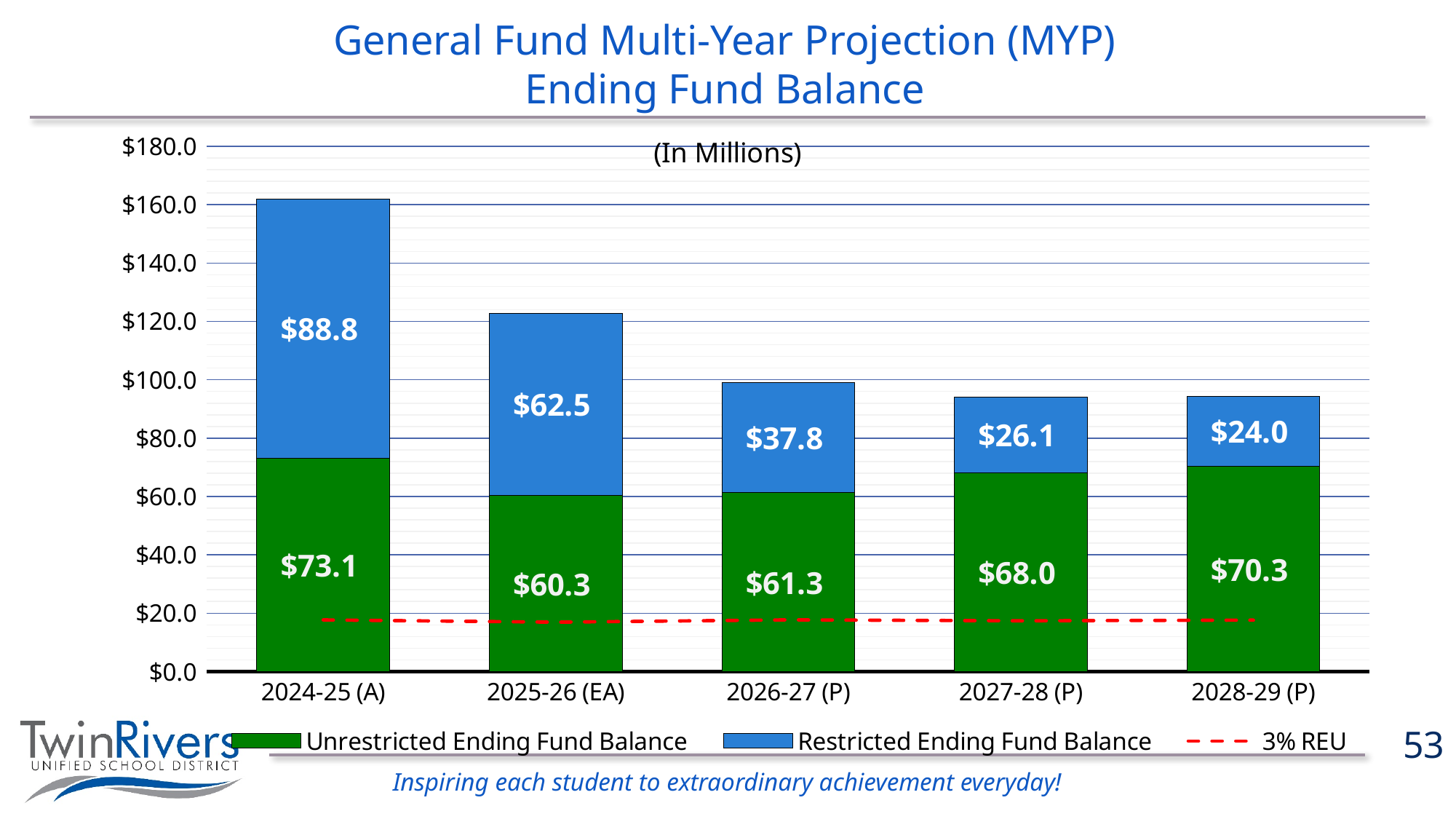
Which year has the lowest Unrestricted Ending Fund Balance? 2025-26 (EA) What is the Unrestricted Ending Fund Balance for 2027-28 (P)? $68.0 Which year has the highest Restricted Ending Fund Balance? 2024-25 (A) What kind of chart is shown on the slide? Stacked bar chart What is the Restricted Ending Fund Balance for 2028-29 (P)? $24.0 How many fiscal years are shown on the x axis? 5 Does the Restricted Ending Fund Balance rise or fall from 2024-25 (A) to 2028-29 (P)? Fall What is the difference between the Restricted Ending Fund Balance in 2025-26 (EA) and 2026-27 (P)? $24.7 What is the Restricted Ending Fund Balance for 2024-25 (A)? $88.8 Is the Unrestricted Ending Fund Balance larger in 2028-29 (P) or in 2026-27 (P)? 2028-29 (P) What is the total ending fund balance (Unrestricted plus Restricted) for 2024-25 (A)? $161.9 How many entries does the legend list? 3